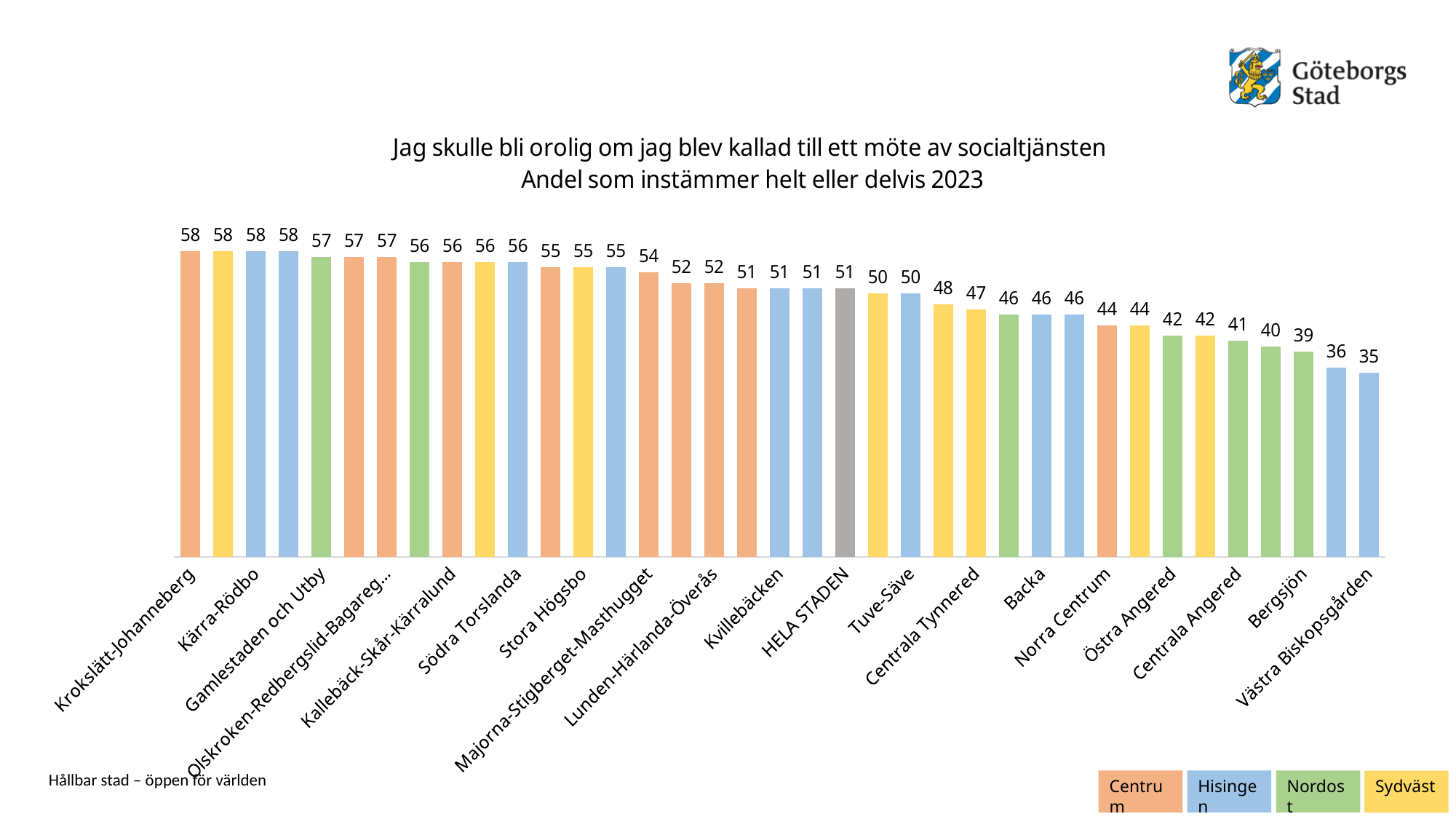
What is the difference between the values for Krokslätt-Johanneberg and Västra Biskopsgården? 23 What is the value for Stora Högsbo? 55 Do the values rise or fall from left to right along the x axis? Fall What is the value for Backa? 46 Which category has the lowest value? Västra Biskopsgården What kind of chart is shown on the slide? Bar chart How many bars are plotted in the chart? 37 Which has a larger value, Tuve-Säve or Centrala Angered? Tuve-Säve What is the value for Bergsjön? 39 What is the value for HELA STADEN? 51 How many entries does the legend list? 4 Which legend entry is shown in green? Nordost